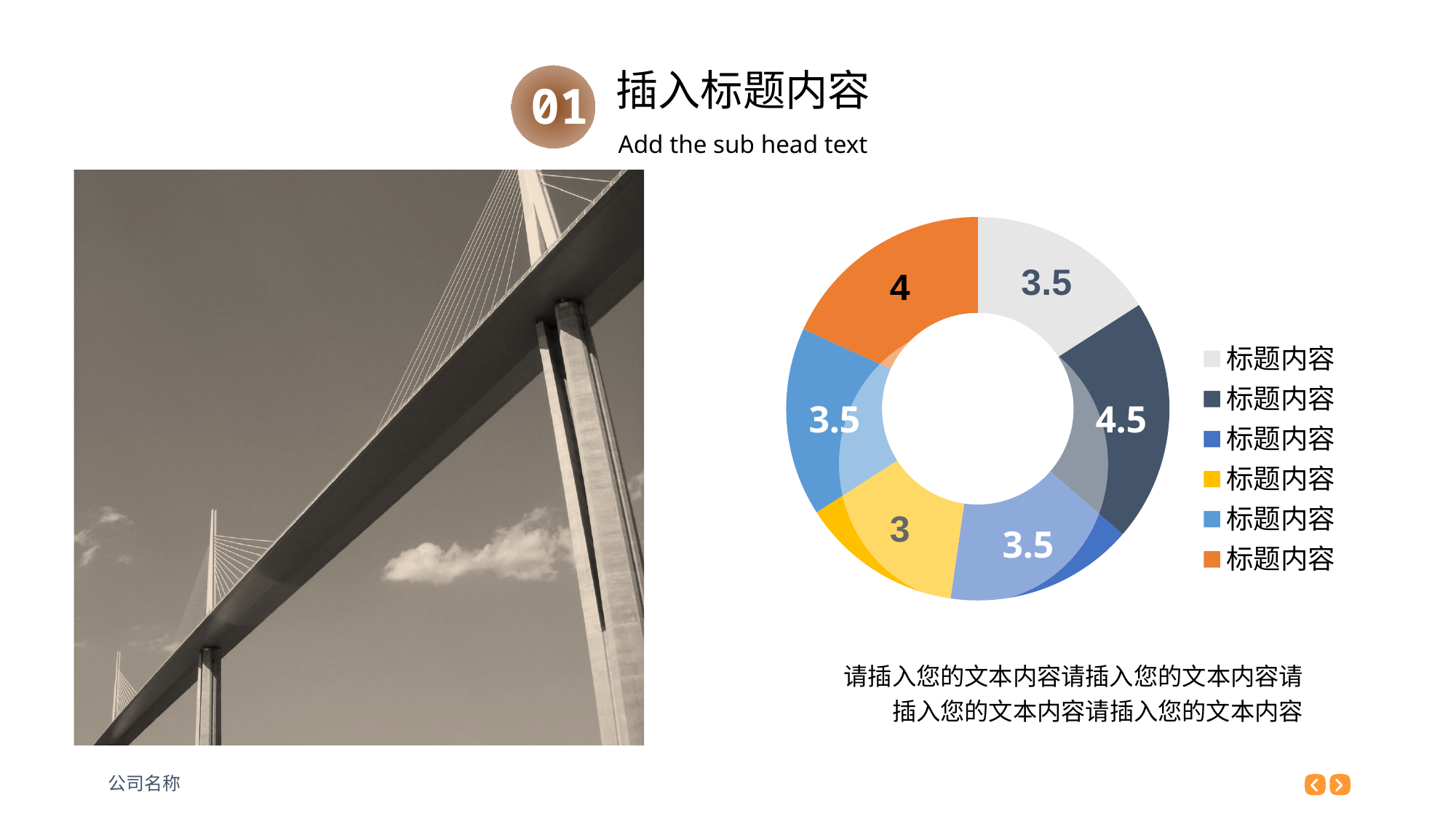
What is the value of the light gray slice at the top right? 3.5 What is the difference between the largest slice value and the smallest slice value? 1.5 What is the total of all the slice values in the doughnut chart? 22 Which slice has the highest value? The dark blue slice (4.5) What is the value of the orange slice? 4 What kind of chart is shown on the slide? Doughnut chart Which slice has the lowest value? The yellow slice (3) How many slices does the doughnut chart have? 6 How many entries does the chart's legend list? 6 What is the value of the yellow slice? 3 What is the value of the dark blue slice? 4.5 Which is larger, the orange slice or the yellow slice? The orange slice